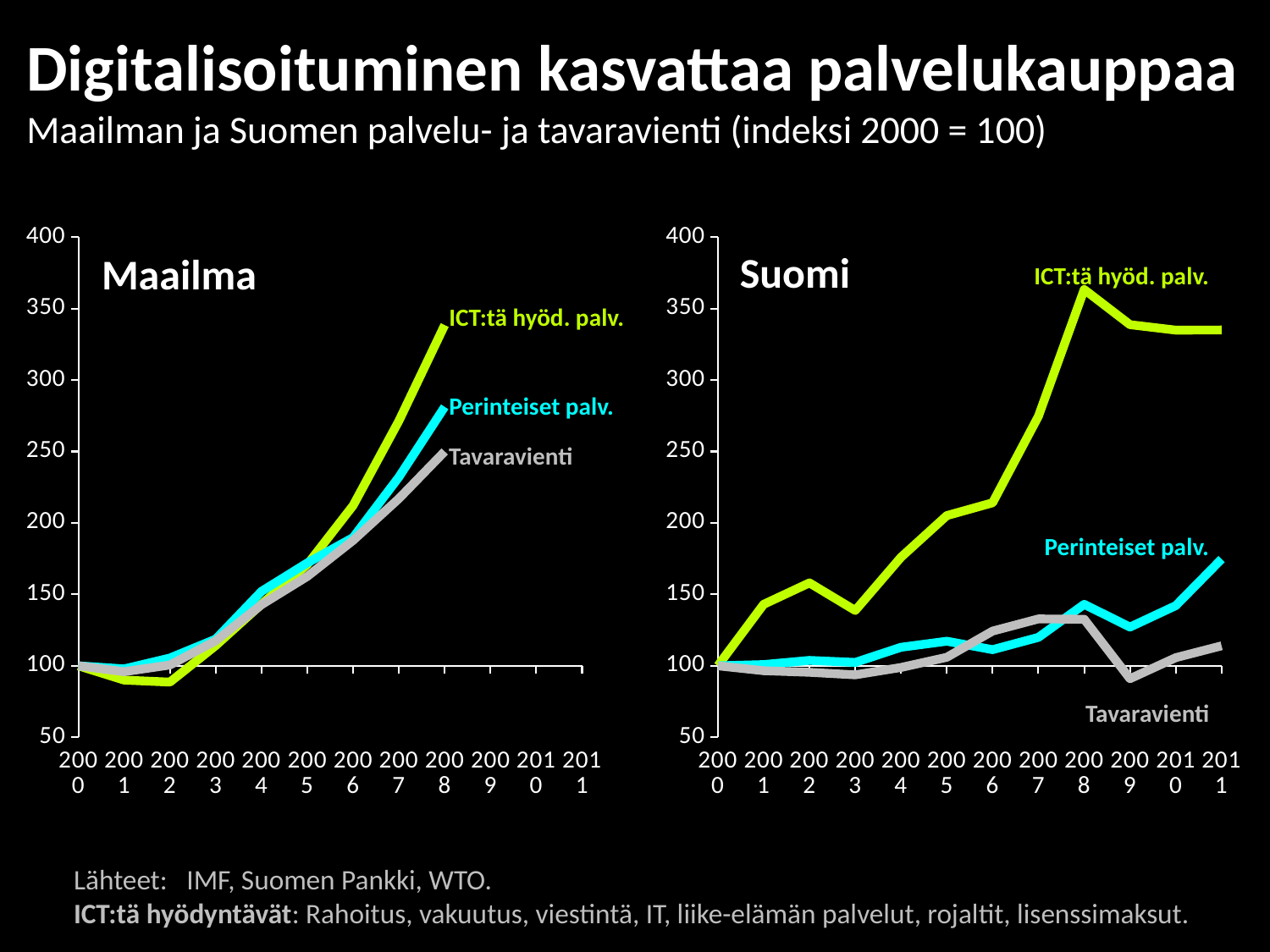
In the Maailma chart, which series has the highest value in 2008? ICT:tä hyöd. palv. In the Suomi chart, is the value for Perinteiset palv. in 2011 greater or less than 150? greater In the Suomi chart, which series has the lowest value in 2011? Tavaravienti In the Suomi chart, which is larger in 2011: ICT:tä hyöd. palv. or Perinteiset palv.? ICT:tä hyöd. palv. In the Maailma chart, does the ICT:tä hyöd. palv. series rise or fall from 2002 to 2008? rise How many series are plotted in the Suomi chart? 3 In the Maailma chart, is the value for Tavaravienti in 2008 greater or less than 300? less In the Maailma chart, is the value for ICT:tä hyöd. palv. in 2008 greater or less than 300? greater What type of chart is used on the slide for the Maailma and Suomi panels? line chart How many years are shown on the x axis of the Suomi chart? 12